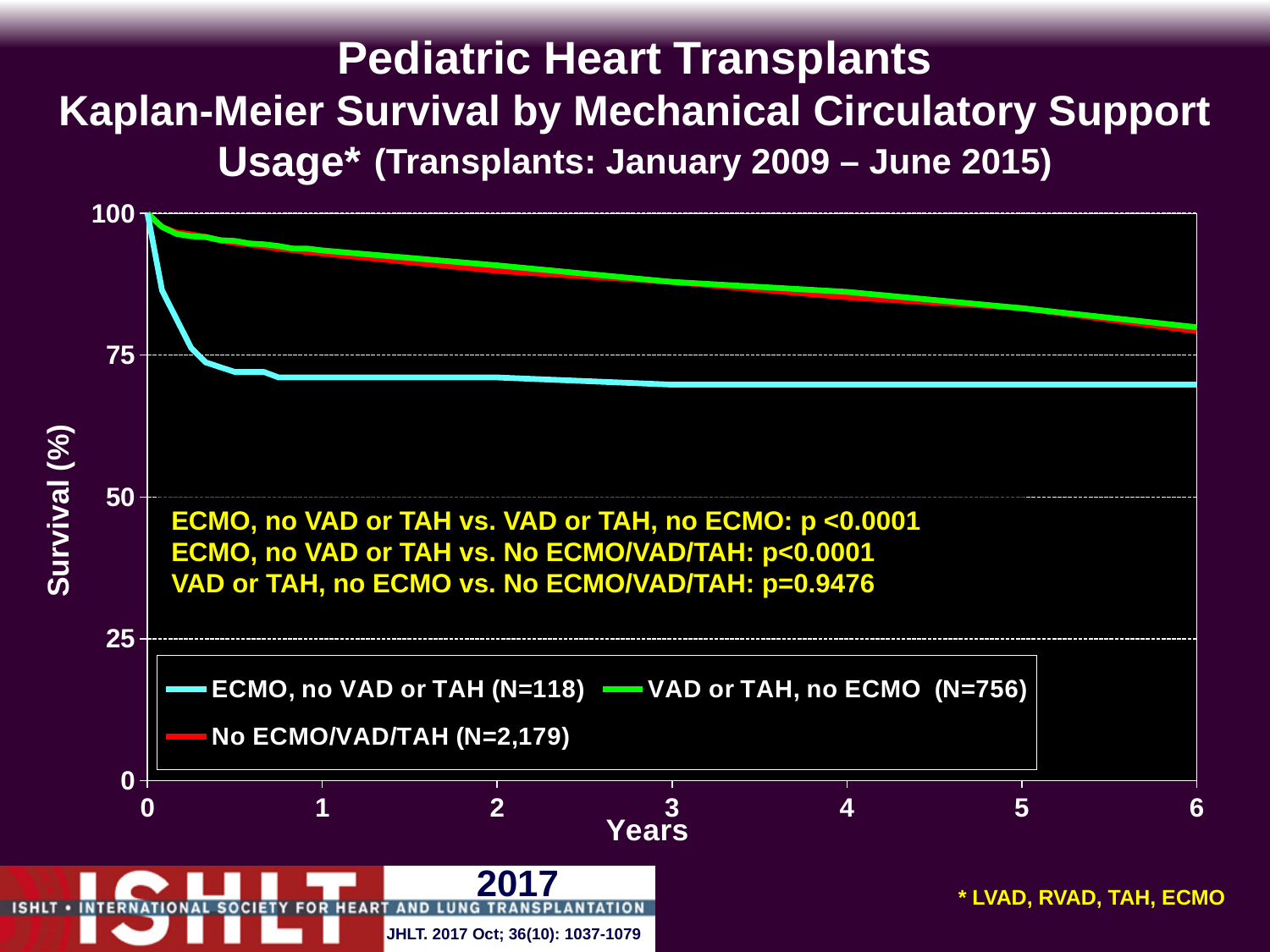
What colour is the line for the ECMO, no VAD or TAH group? light blue How many series does the legend list? 3 Which group has the lowest survival at 6 years? ECMO, no VAD or TAH Is the survival for the ECMO, no VAD or TAH group at 6 years greater or less than 75%? less What is the N for the VAD or TAH, no ECMO group shown in the legend? N=756 What is the N for the No ECMO/VAD/TAH group shown in the legend? N=2,179 What is the N for the ECMO, no VAD or TAH group shown in the legend? N=118 Do the survival curves rise or fall as years increase? fall What p-value is shown for VAD or TAH, no ECMO vs. No ECMO/VAD/TAH? p=0.9476 Is the survival for the VAD or TAH, no ECMO group at 6 years greater or less than 75%? greater At 3 years, which group has higher survival: ECMO, no VAD or TAH, or VAD or TAH, no ECMO? VAD or TAH, no ECMO What kind of chart is shown on the slide? line chart